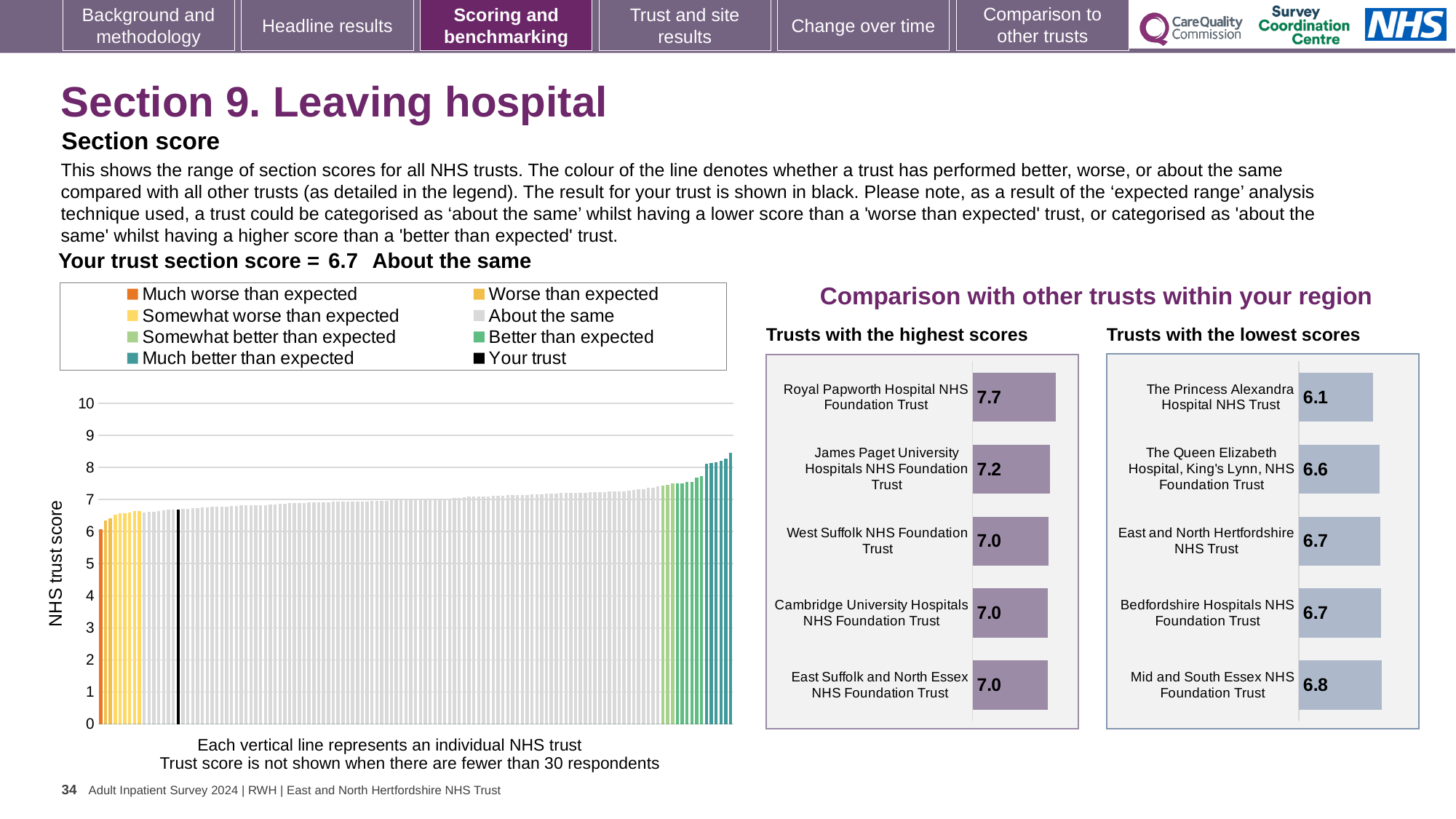
How many trusts are shown in the 'Trusts with the highest scores' chart? 5 In the 'Trusts with the highest scores' chart, what is the difference between the scores of Royal Papworth Hospital NHS Foundation Trust and James Paget University Hospitals NHS Foundation Trust? 0.5 In the left-hand NHS trust score chart, is the value of the tallest bar greater or less than 8? greater In the 'Trusts with the lowest scores' chart, what is the score for The Princess Alexandra Hospital NHS Trust? 6.1 In the 'Trusts with the highest scores' chart, which trust has the highest score? Royal Papworth Hospital NHS Foundation Trust What kind of chart is the large chart on the left showing NHS trust scores? Bar chart How many entries does the legend of the left-hand NHS trust score chart list? 8 According to the slide, what is your trust's section score for Leaving hospital? 6.7 In the 'Trusts with the lowest scores' chart, which has the larger score: The Queen Elizabeth Hospital, King's Lynn, NHS Foundation Trust or Mid and South Essex NHS Foundation Trust? Mid and South Essex NHS Foundation Trust In the 'Trusts with the highest scores' chart, what is the score for Royal Papworth Hospital NHS Foundation Trust? 7.7 In the 'Trusts with the lowest scores' chart, what is the difference between the scores of Mid and South Essex NHS Foundation Trust and The Princess Alexandra Hospital NHS Trust? 0.7 In the 'Trusts with the lowest scores' chart, which trust has the lowest score? The Princess Alexandra Hospital NHS Trust